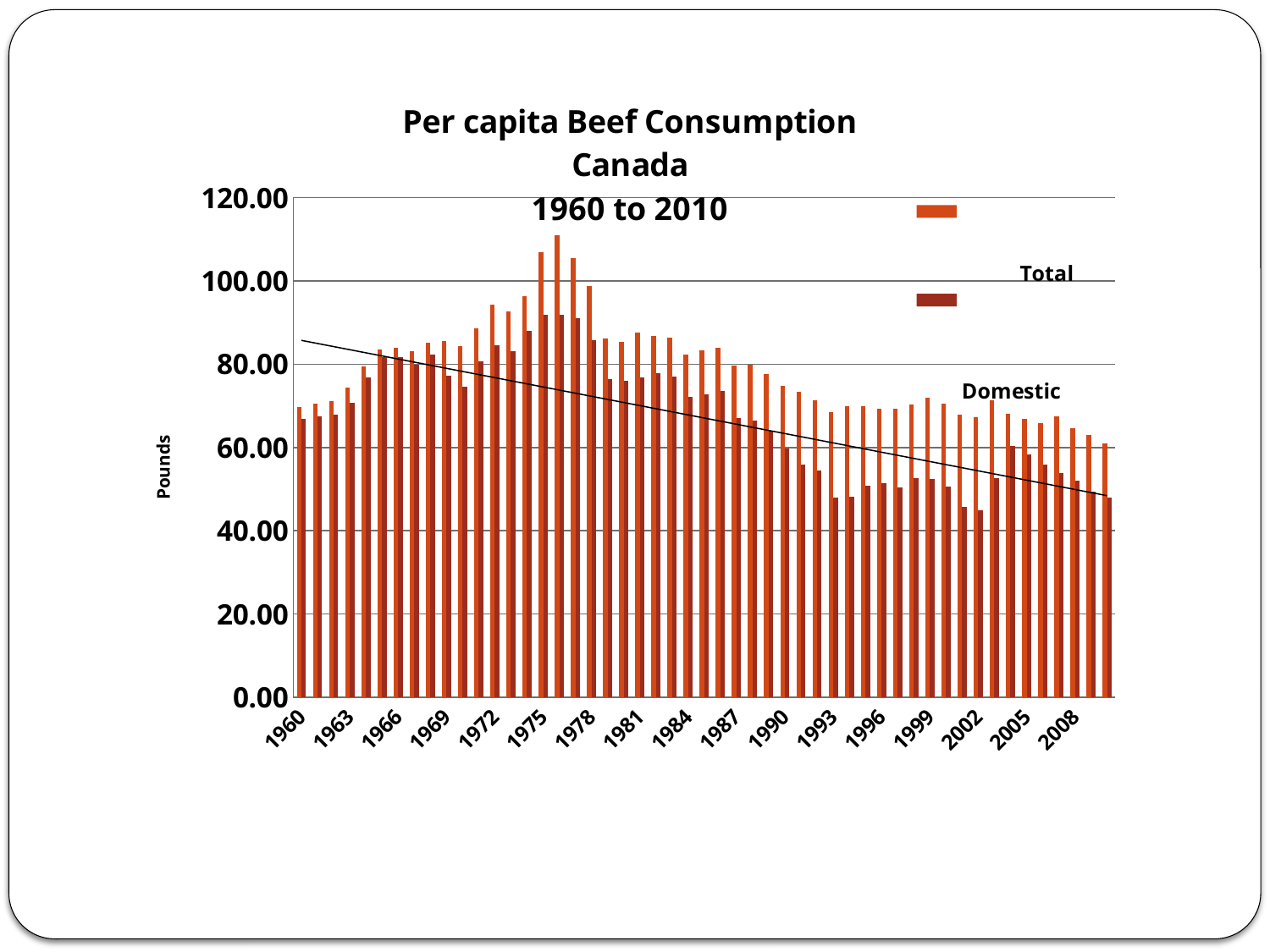
Is the Total value for 1960 greater or less than 80? less What are the two series named in the legend? Total and Domestic Which is larger, the Domestic value for 1966 or the Domestic value for 1996? 1966 Is the Domestic value for 2002 greater or less than 60? less Which year has the highest Total value? 1976 What kind of chart is shown on the slide? bar chart Is the Total value for 1976 greater or less than 100? greater How many series does the legend list? 2 What is the label on the vertical axis? Pounds Does the trend line drawn across the chart rise or fall from left to right? fall